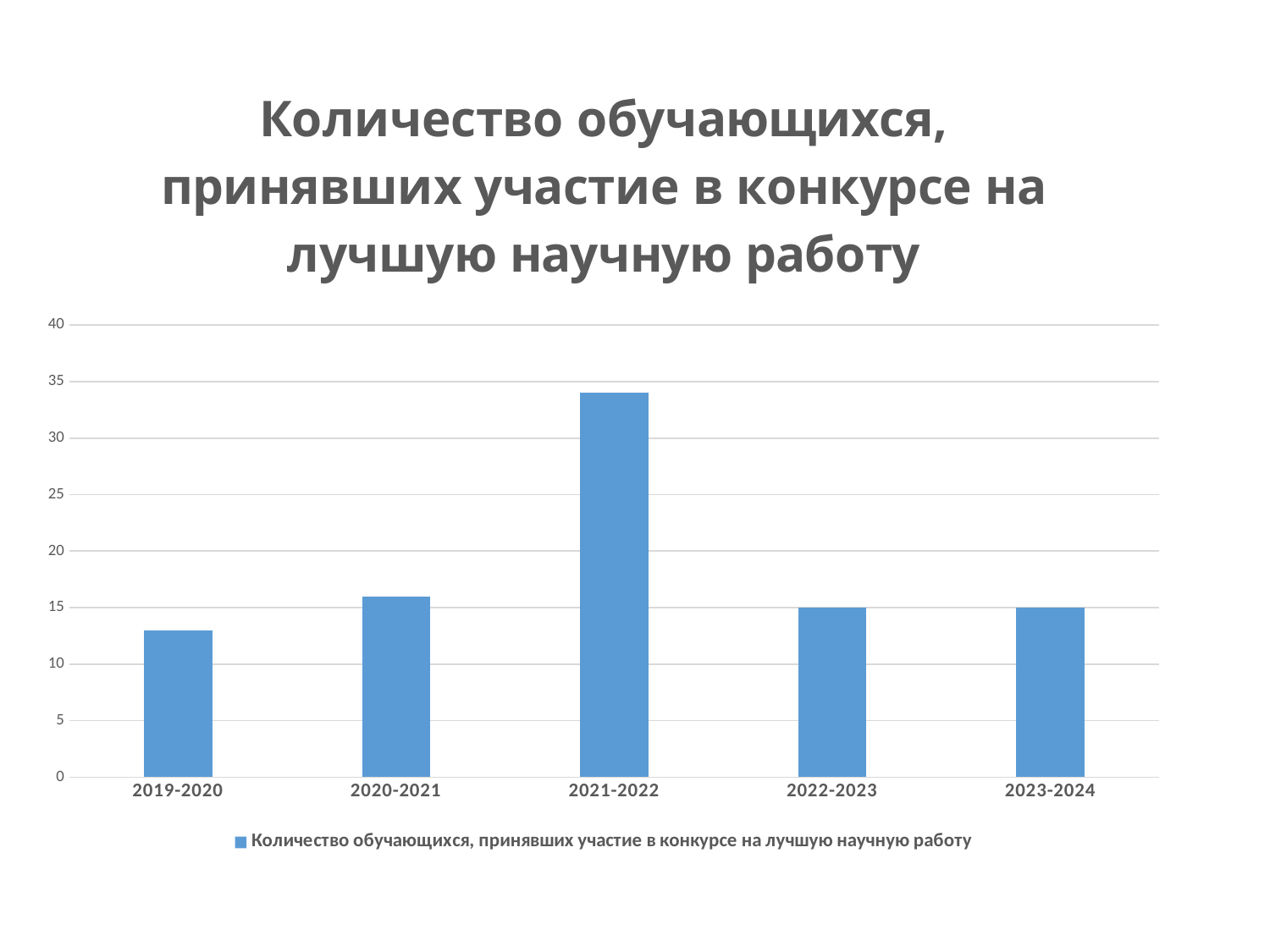
What type of chart is shown on the slide? bar chart What is the title of the chart? Количество обучающихся, принявших участие в конкурсе на лучшую научную работу Is the value for 2021-2022 greater or less than 35? less Which academic year has the lowest number of students who took part in the competition? 2019-2020 Is the value for 2021-2022 greater or less than 30? greater How many series does the legend list? 1 Which academic year has the highest number of students who took part in the competition? 2021-2022 Which is larger, the value for 2019-2020 or the value for 2020-2021? 2020-2021 Is the value for 2019-2020 greater or less than 15? less How many academic years are shown on the x axis of the chart? 5 Do the values rise or fall from 2019-2020 to 2021-2022? rise